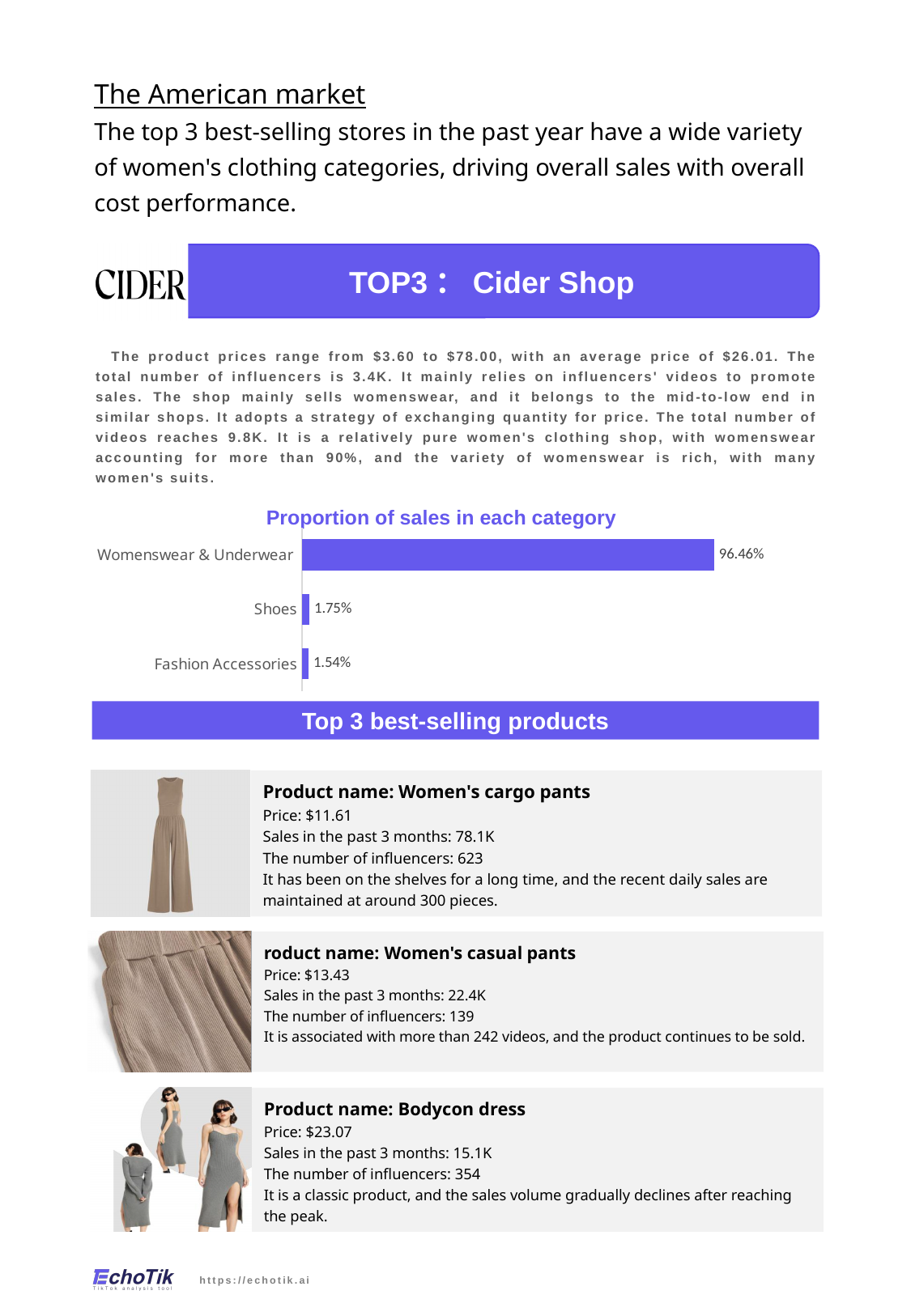
What kind of chart is 'Proportion of sales in each category'? Bar chart Which category has the lowest proportion of sales in the chart? Fashion Accessories What is the value for Womenswear & Underwear in the 'Proportion of sales in each category' chart? 96.46% How many categories are shown in the 'Proportion of sales in each category' chart? 3 Which is larger in the chart, the value for Shoes or the value for Fashion Accessories? Shoes What is the difference between the Shoes and Fashion Accessories values in the chart? 0.21% What is the value for Shoes in the 'Proportion of sales in each category' chart? 1.75% Which category has the highest proportion of sales in the chart? Womenswear & Underwear What is the value for Fashion Accessories in the 'Proportion of sales in each category' chart? 1.54% What is the title of the chart on the slide? Proportion of sales in each category What colour are the bars in the 'Proportion of sales in each category' chart? Purple What is the difference between the Womenswear & Underwear and Shoes values in the chart? 94.71%